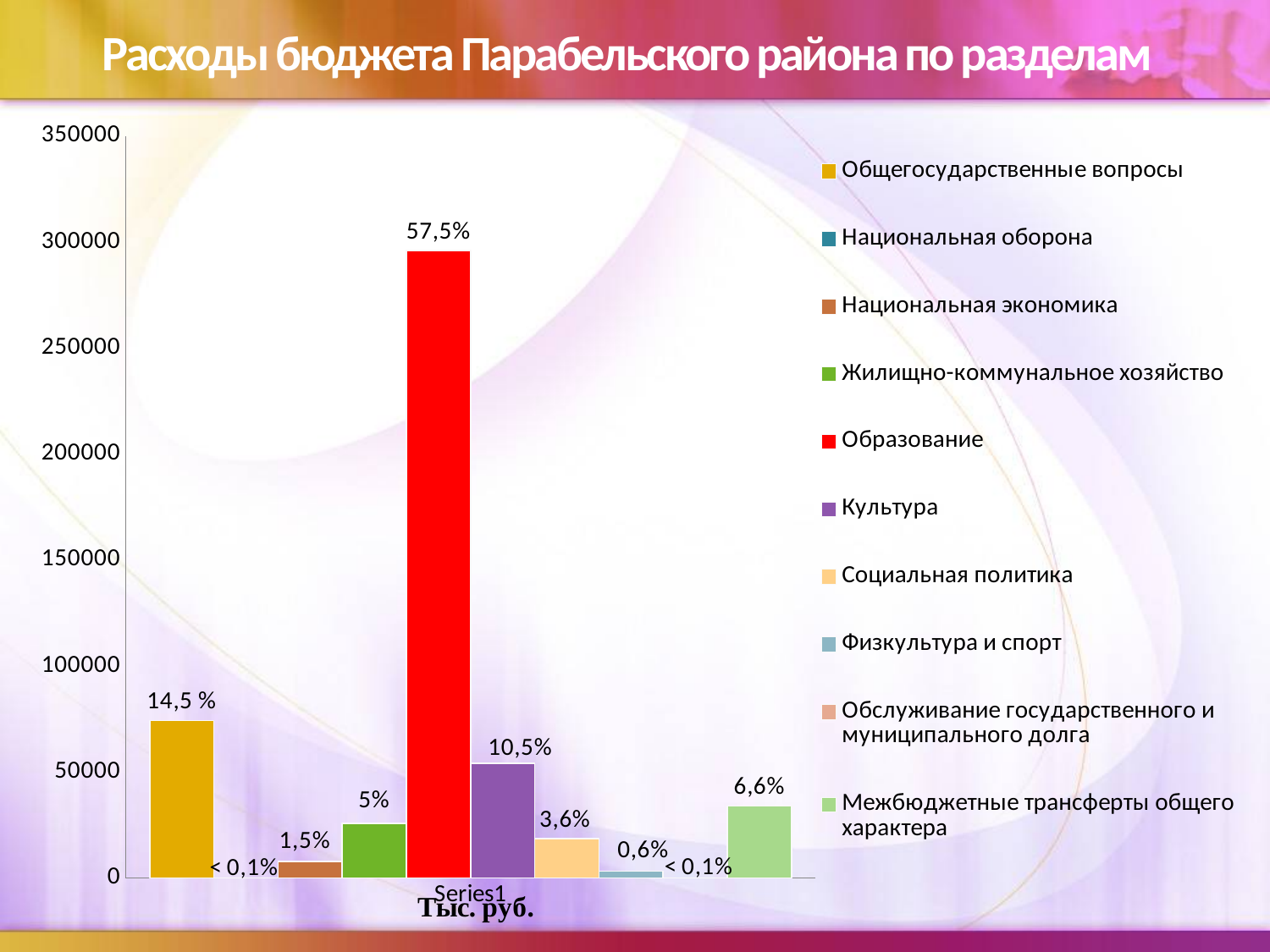
What is the title of the chart? Расходы бюджета Парабельского района по разделам What colour is the bar for Образование? Red What percentage label is shown on the bar for Образование? 57,5% What percentage label is shown on the bar for Культура? 10,5% How many series does the legend list? 10 Which section has the highest expenditure? Образование Is the value for Образование greater or less than 250000? greater What percentage label is shown on the bar for Общегосударственные вопросы? 14,5 % Which is larger, the bar for Культура or the bar for Межбюджетные трансферты общего характера? Культура What percentage label is shown on the bar for Физкультура и спорт? 0,6% What percentage label is shown on the bar for Межбюджетные трансферты общего характера? 6,6% What kind of chart is shown on the slide? Bar chart